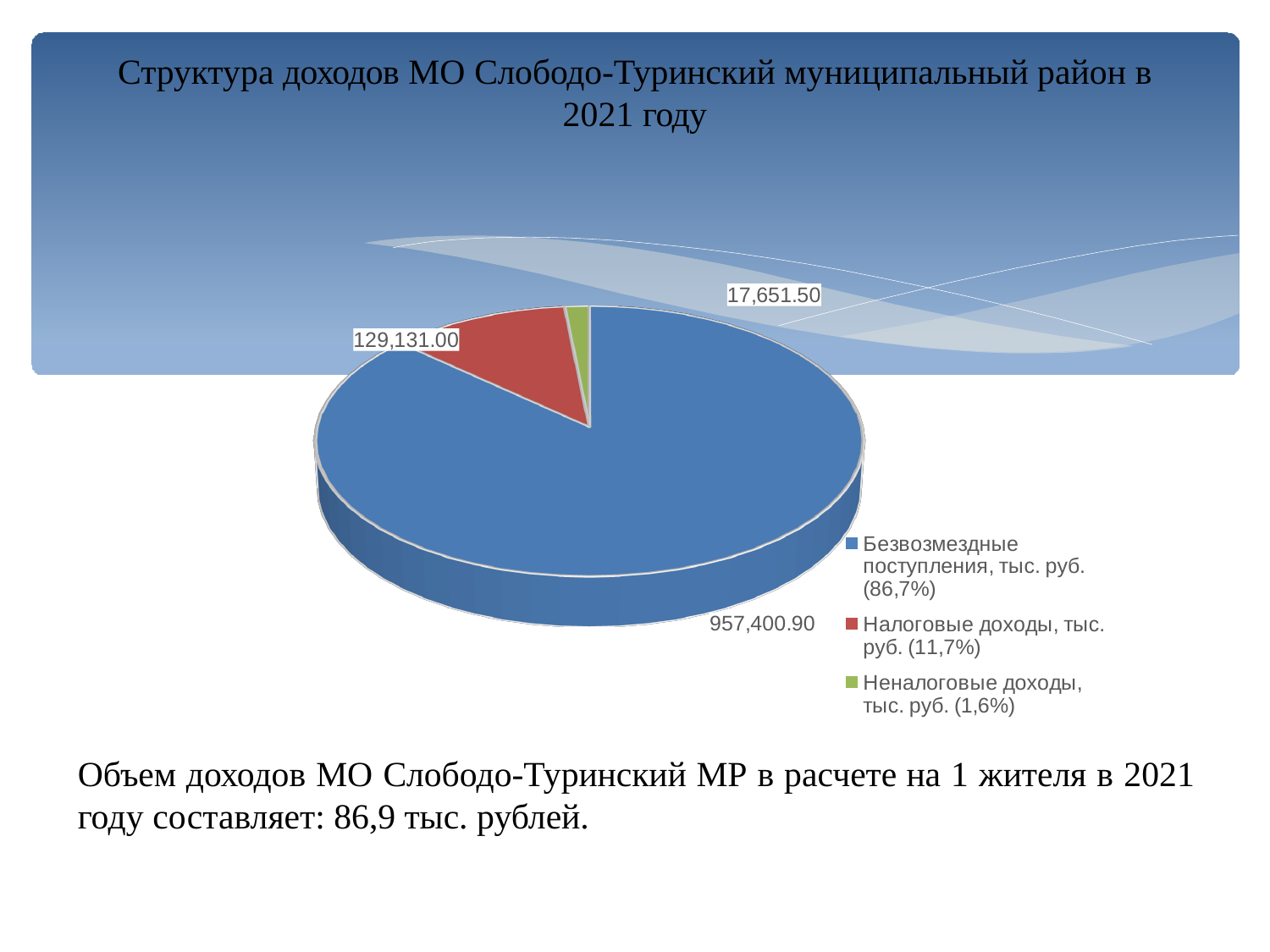
What is the value for Налоговые доходы? 129,131.00 What is the difference between the values for Безвозмездные поступления and Налоговые доходы? 828,269.90 What share of the pie does Безвозмездные поступления represent? 86,7% Which is larger, the value for Налоговые доходы or the value for Неналоговые доходы? Налоговые доходы Which category has the smallest slice of the pie? Неналоговые доходы What type of chart is shown on the slide? Pie chart Which category has the largest slice of the pie? Безвозмездные поступления What is the value for Безвозмездные поступления? 957,400.90 How many categories does the pie chart have? 3 What share of the pie does Налоговые доходы represent? 11,7% What colour is the slice for Неналоговые доходы? Green What is the value for Неналоговые доходы? 17,651.50